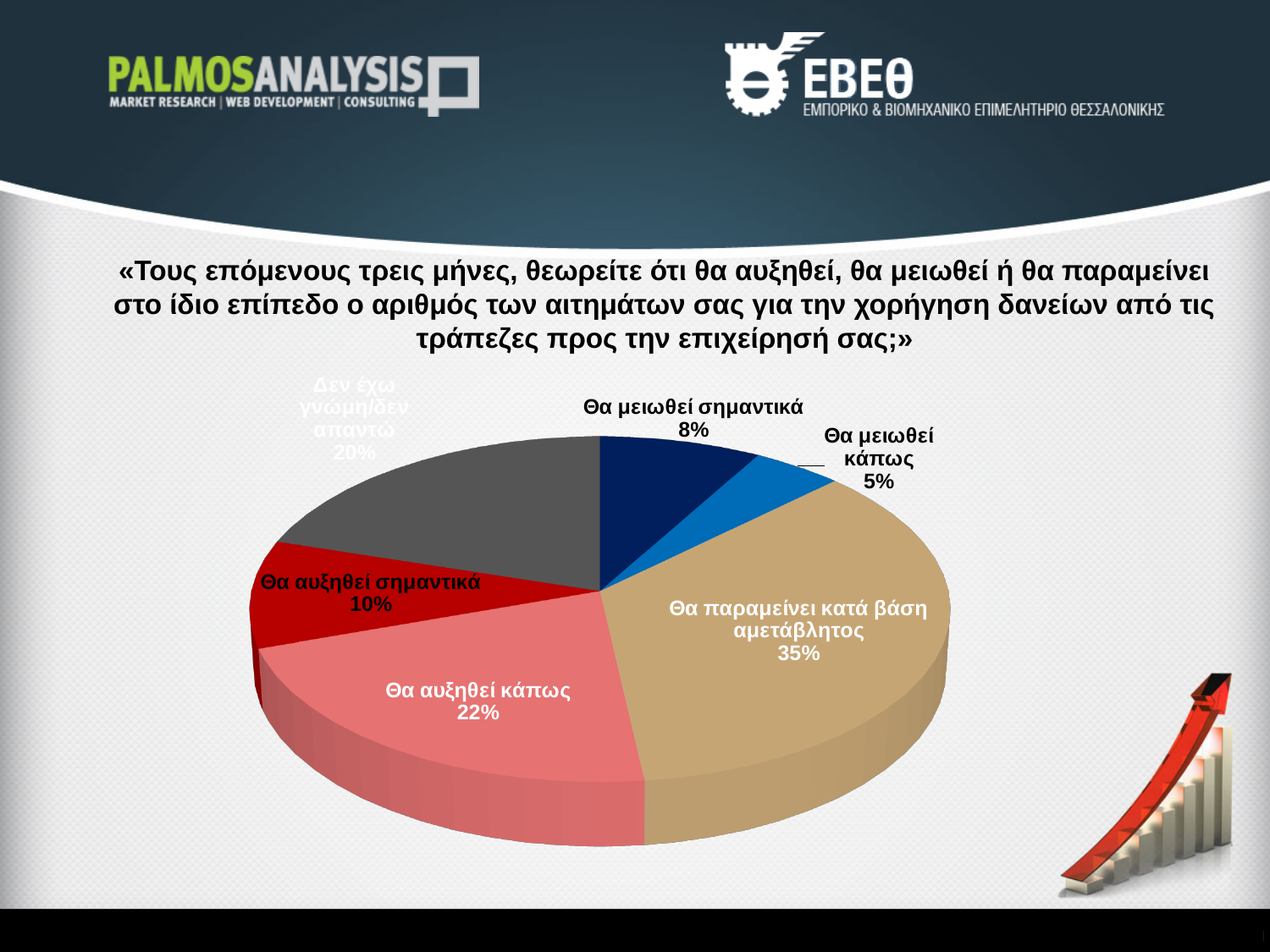
What colour is the slice for «Θα αυξηθεί σημαντικά»? Dark red Which response has the smallest slice of the pie? Θα μειωθεί κάπως What percentage of respondents answered «Θα παραμείνει κατά βάση αμετάβλητος»? 35% What kind of chart is shown on the slide? Pie chart What is the combined share of «Θα μειωθεί σημαντικά» and «Θα μειωθεί κάπως»? 13% What percentage is shown for «Θα μειωθεί σημαντικά»? 8% What is the difference in percentage points between «Θα αυξηθεί κάπως» and «Θα αυξηθεί σημαντικά»? 12 What percentage is shown for «Δεν έχω γνώμη/δεν απαντώ»? 20% Which is larger: the share for «Θα μειωθεί σημαντικά» or the share for «Θα αυξηθεί σημαντικά»? Θα αυξηθεί σημαντικά How many slices does the pie chart have? 6 Which response has the largest slice of the pie? Θα παραμείνει κατά βάση αμετάβλητος What share is shown for «Θα αυξηθεί κάπως»? 22%